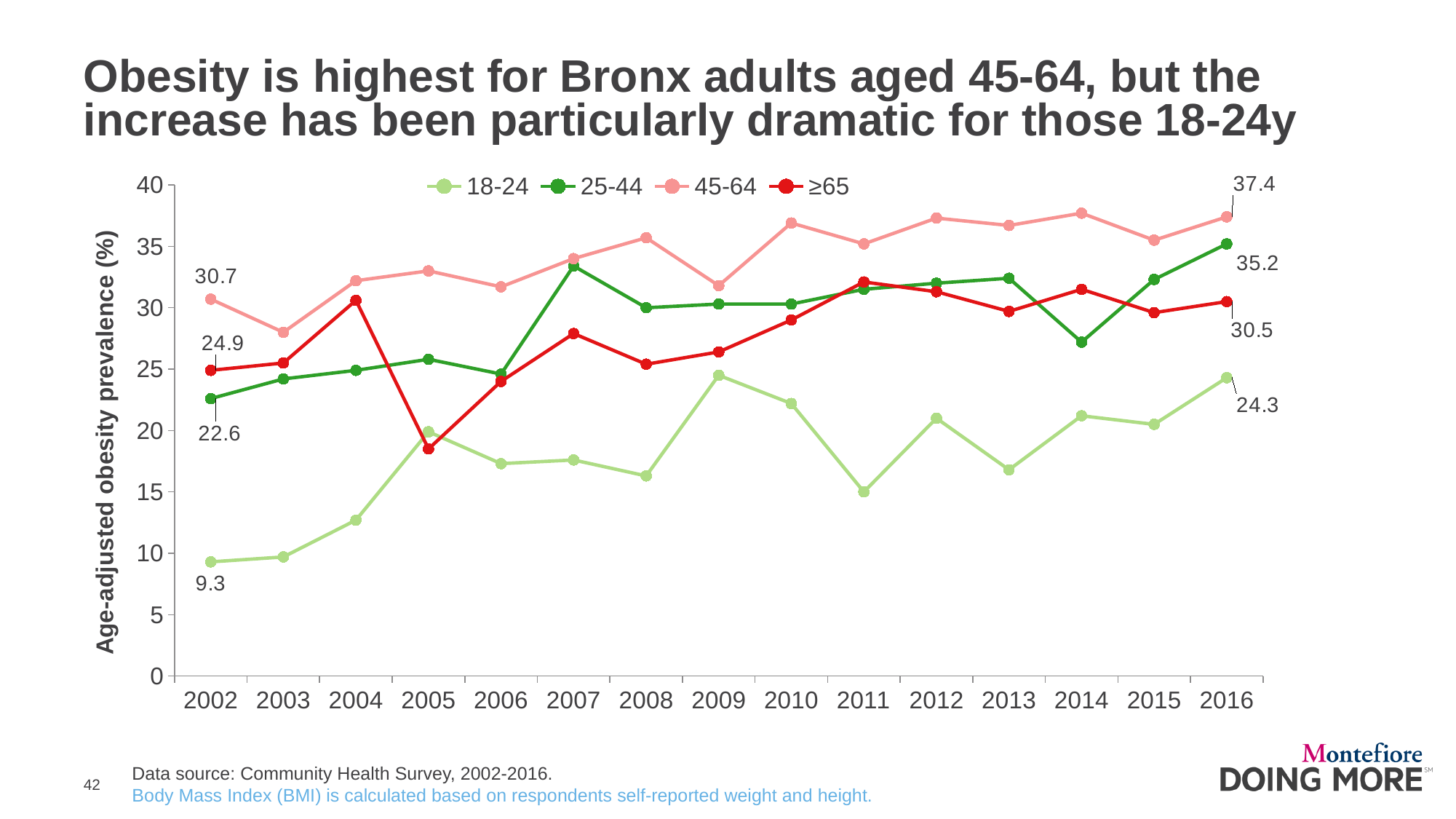
Which age group had the lowest obesity prevalence in 2002? 18-24 Is the value for the 18-24 group in 2011 greater or less than 20? less What type of chart is shown on the slide? line chart How many series does the legend list? 4 Which age group had the highest obesity prevalence in 2016? 45-64 What was the age-adjusted obesity prevalence for the 18-24 group in 2002? 9.3 Which is larger in 2016: the value for the 25-44 group or the ≥65 group? 25-44 What was the age-adjusted obesity prevalence for the 25-44 group in 2002? 22.6 By how much did the obesity prevalence for the 18-24 group increase from 2002 to 2016? 15.0 What was the age-adjusted obesity prevalence for the 45-64 group in 2016? 37.4 How many years are shown on the x axis? 15 What was the age-adjusted obesity prevalence for the ≥65 group in 2016? 30.5